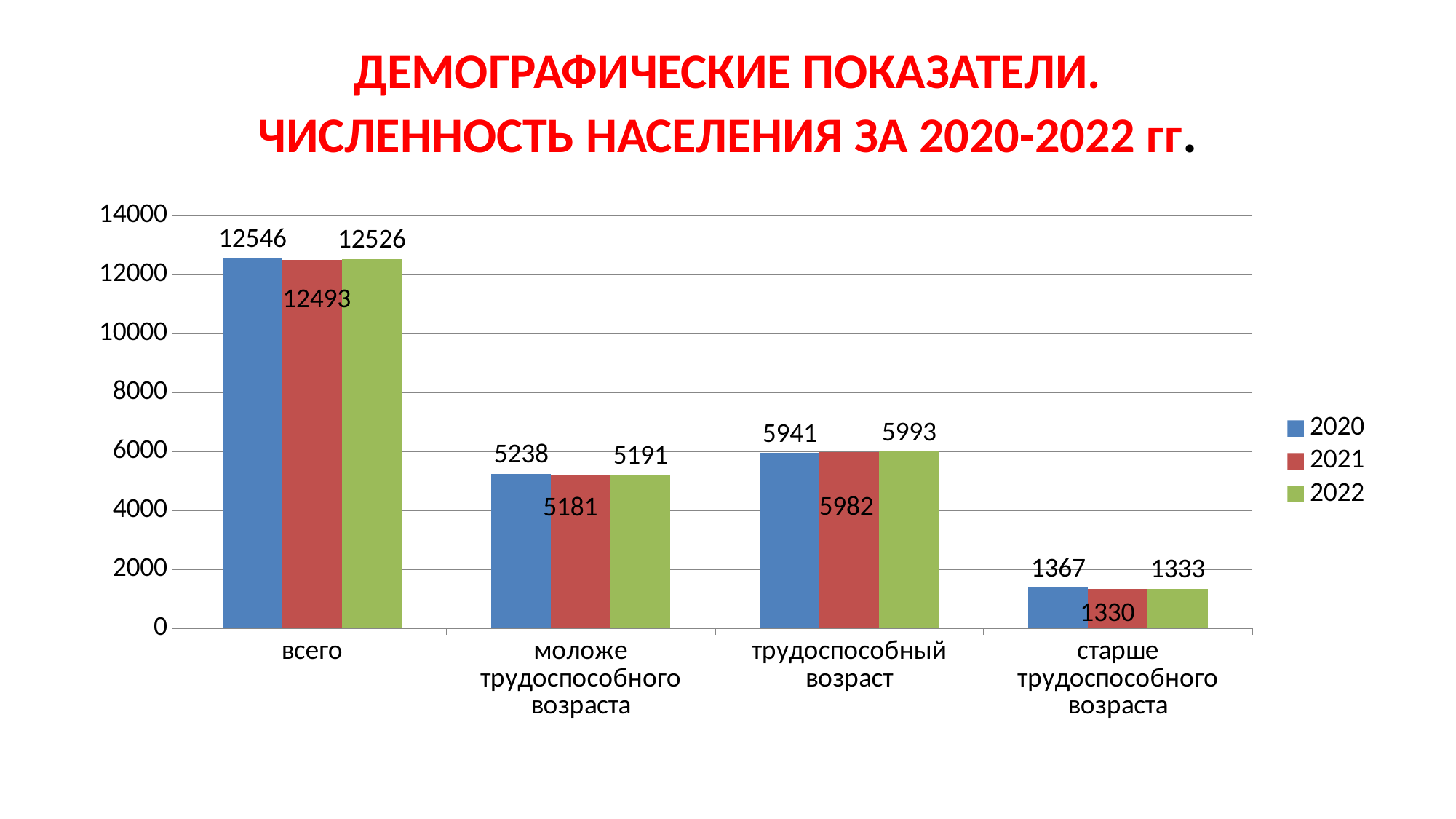
What is the difference between the 2020 and 2022 values in the "всего" category? 20 How many series does the legend list? 3 Which category has the highest value for 2022? всего How many categories are shown on the x axis? 4 What is the value for 2022 in the "старше трудоспособного возраста" category? 1333 What is the difference between the 2022 and 2020 values in the "трудоспособный возраст" category? 52 What is the value for 2021 in the "моложе трудоспособного возраста" category? 5181 What is the value for 2021 in the "трудоспособный возраст" category? 5982 Which is larger: the 2020 value for "моложе трудоспособного возраста" or the 2020 value for "трудоспособный возраст"? трудоспособный возраст Which category has the lowest value for 2020? старше трудоспособного возраста What is the value for 2020 in the "всего" category? 12546 What kind of chart is shown on the slide? bar chart